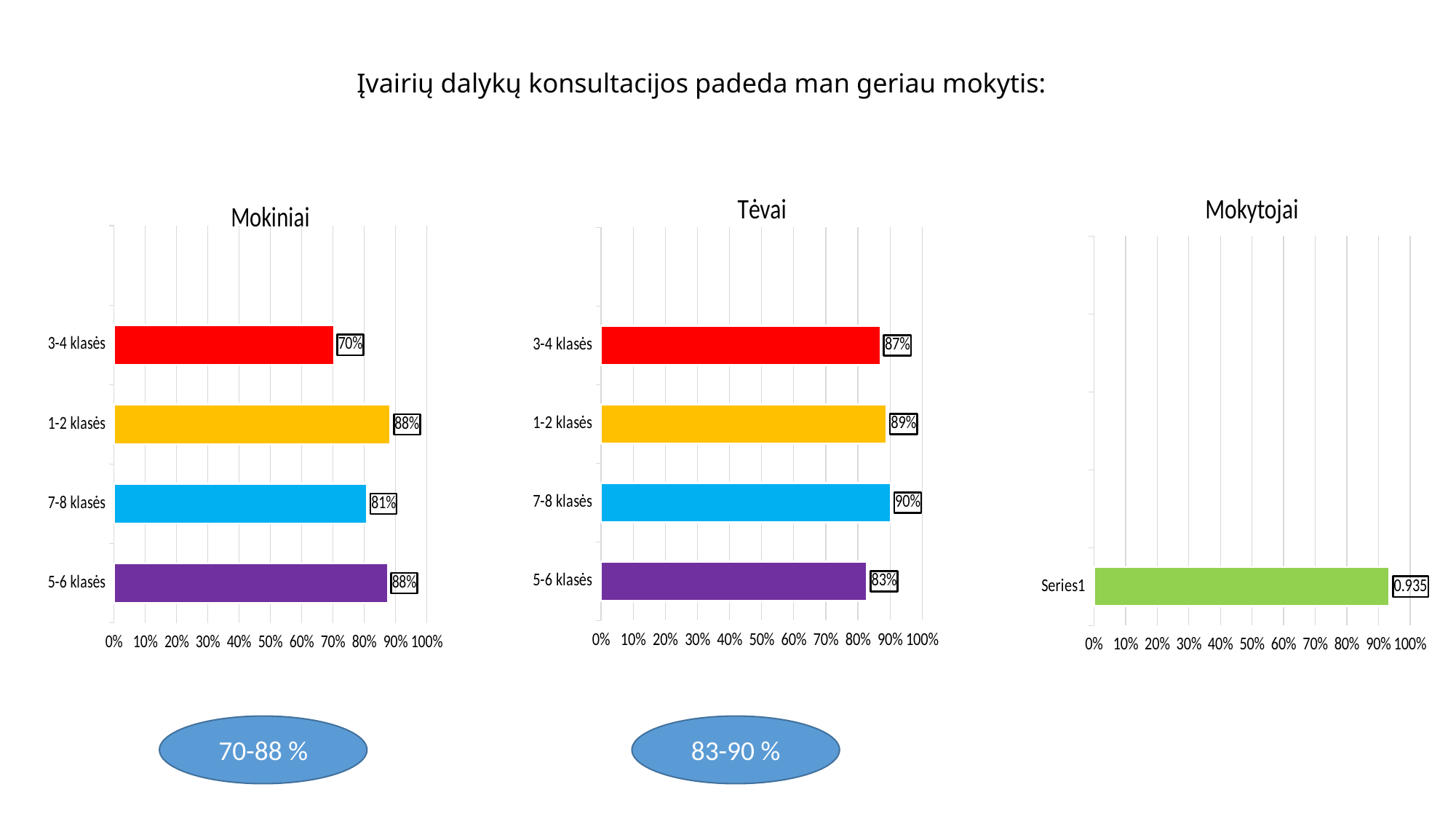
In the Mokiniai chart, which category has the lowest value? 3-4 klasės Which is larger: the value for 3-4 klasės in the Mokiniai chart or the value for 3-4 klasės in the Tėvai chart? Tėvai In the Mokiniai chart, what is the difference between the values for 1-2 klasės and 3-4 klasės? 18% What kind of chart is the Tėvai chart? bar chart In the Mokiniai chart, what is the value for 7-8 klasės? 81% How many categories does the Mokiniai chart show? 4 In the Tėvai chart, what is the value for 5-6 klasės? 83% In the Tėvai chart, which category has the highest value? 7-8 klasės In the Mokiniai chart, what is the value for 3-4 klasės? 70% In the Tėvai chart, which category has the lowest value? 5-6 klasės In the Mokytojai chart, what is the value for Series1? 0.935 In the Tėvai chart, what is the difference between the values for 7-8 klasės and 5-6 klasės? 7%